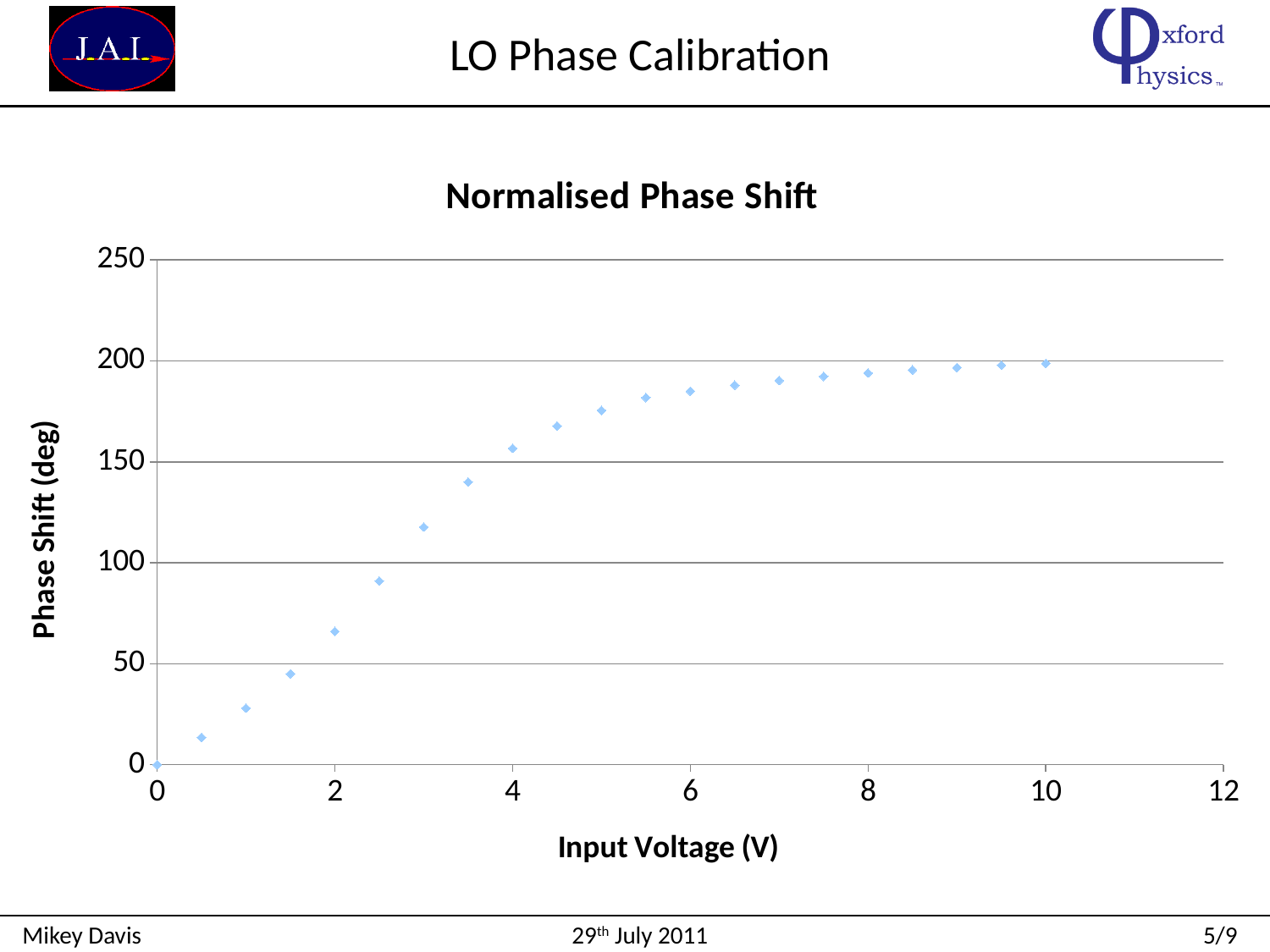
How many data points are plotted on the chart? 21 At which input voltage is the phase shift highest? 10 What is the label of the y axis? Phase Shift (deg) What is the title of the chart? Normalised Phase Shift Is the phase shift at an input voltage of 3 V greater or less than 100? greater Is the phase shift at an input voltage of 2.5 V greater or less than 100? less Is the phase shift at an input voltage of 2 V greater or less than 50? greater At which input voltage is the phase shift lowest? 0 What kind of chart is shown on the slide? scatter chart Do the phase shift values rise or fall as input voltage increases? rise Which has the larger phase shift: an input voltage of 2 V or 4 V? 4 V